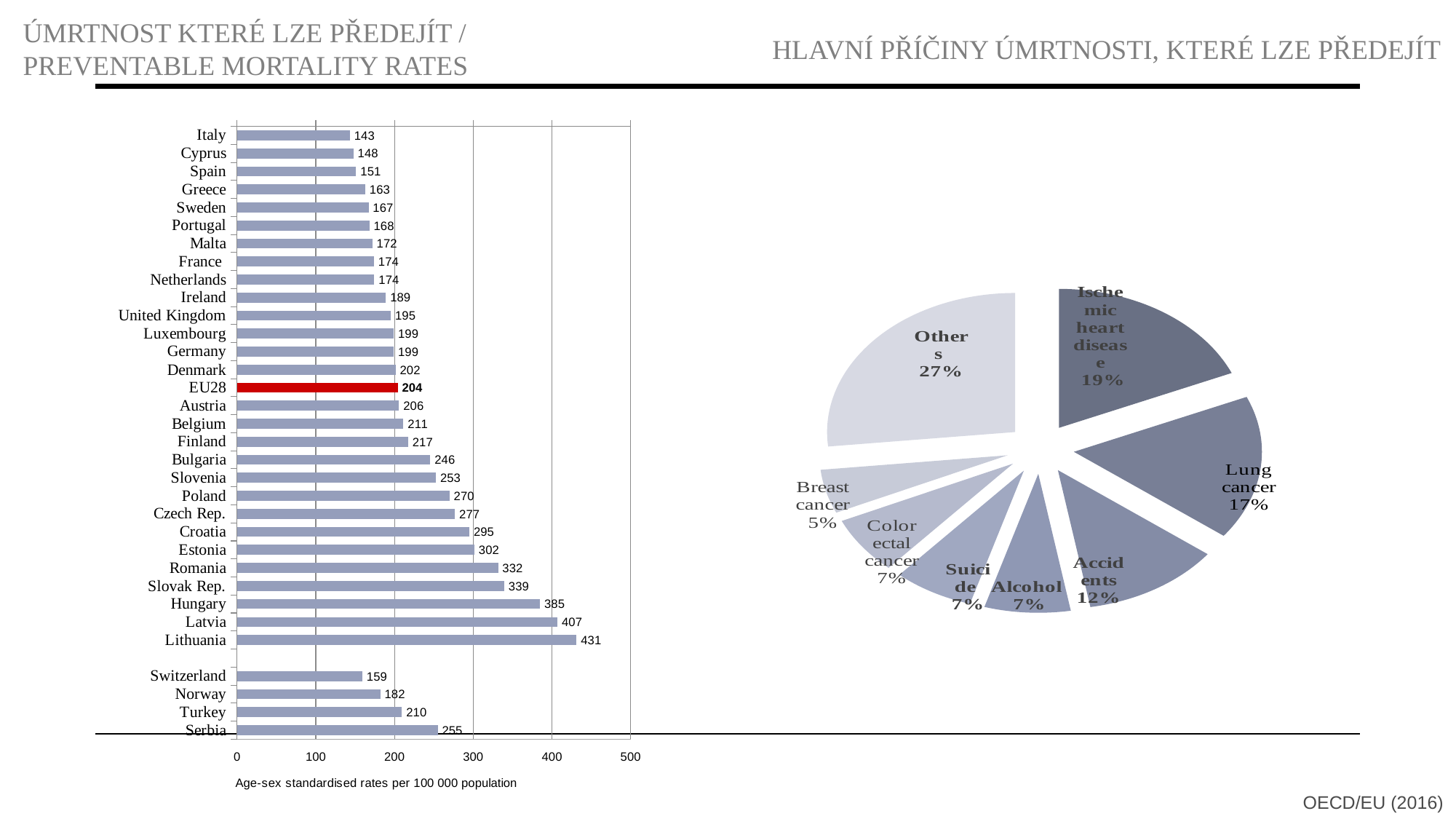
On the left bar chart, what is the value shown for EU28? 204 On the left bar chart, which bar is highlighted in red? EU28 On the left bar chart, what is the value shown for Serbia? 255 On the left bar chart, what is the difference between the values for Latvia and Hungary? 22 On the left bar chart, what is the preventable mortality rate for Lithuania? 431 On the right pie chart, what share is attributed to Ischemic heart disease? 19% On the left bar chart, which has a higher value, Norway or Switzerland? Norway On the right pie chart, how many slices are there? 8 What type of chart is shown on the left side of the slide? Bar chart On the left bar chart, which country has the highest preventable mortality rate? Lithuania On the right pie chart, what share is attributed to Breast cancer? 5% On the left bar chart, which country has the lowest preventable mortality rate? Italy